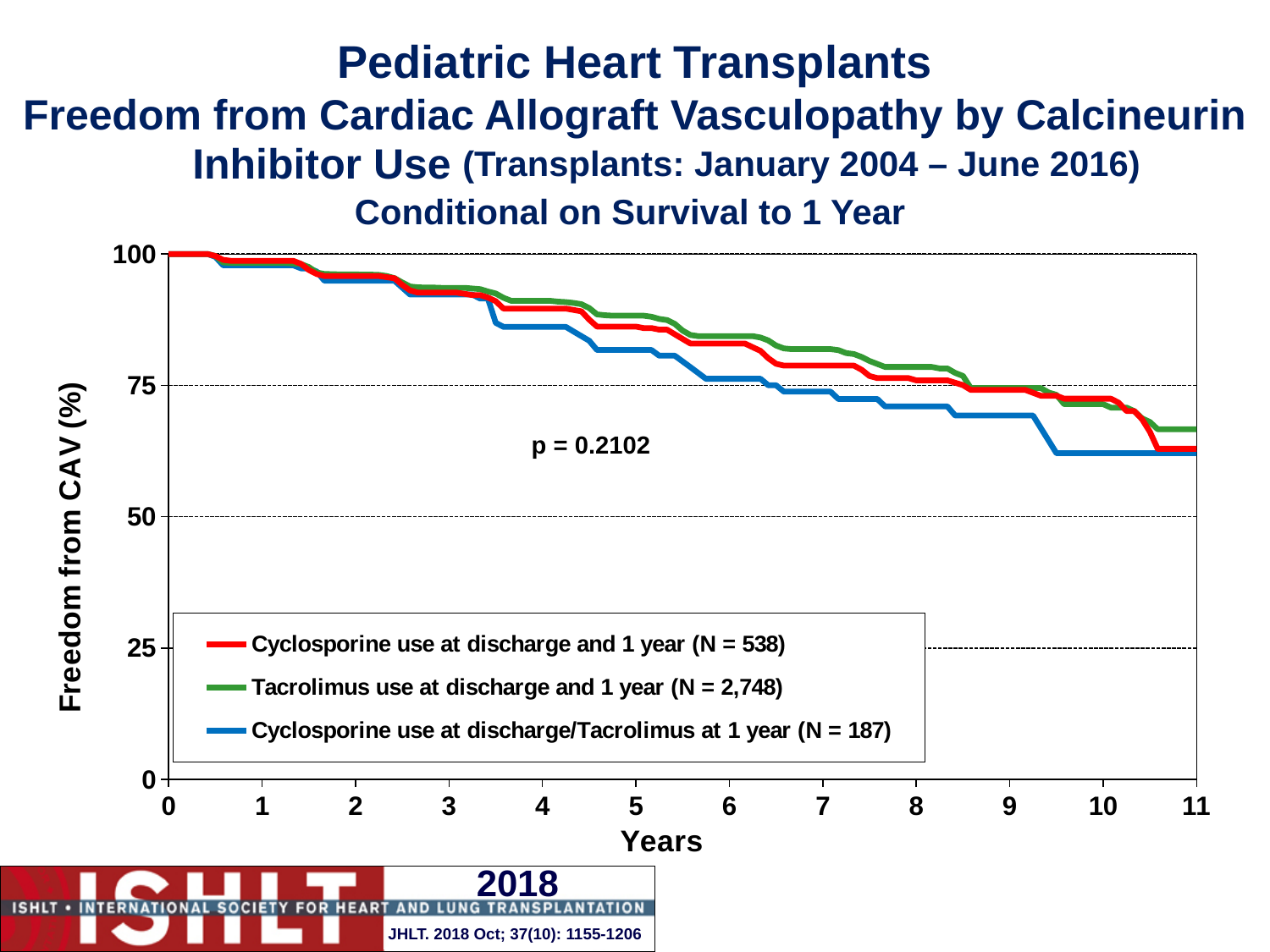
Is the value for the Cyclosporine use at discharge/Tacrolimus at 1 year series at year 11 greater or less than 50? greater Is the value for the Cyclosporine use at discharge/Tacrolimus at 1 year series at year 10 greater or less than 75? less What kind of chart is shown on the slide? line chart At year 5, which is higher: the Cyclosporine use at discharge and 1 year series or the Cyclosporine use at discharge/Tacrolimus at 1 year series? Cyclosporine use at discharge and 1 year Is the value for the Cyclosporine use at discharge and 1 year series at year 3 greater or less than 75? greater At year 7, which is higher: the Tacrolimus use at discharge and 1 year series or the Cyclosporine use at discharge/Tacrolimus at 1 year series? Tacrolimus use at discharge and 1 year What is the N for the Tacrolimus use at discharge and 1 year group shown in the legend? 2,748 Do the freedom from CAV values rise or fall as years increase? fall What p-value is printed on the chart? p = 0.2102 At year 10, which series has the lowest freedom from CAV? Cyclosporine use at discharge/Tacrolimus at 1 year How many series does the legend list? 3